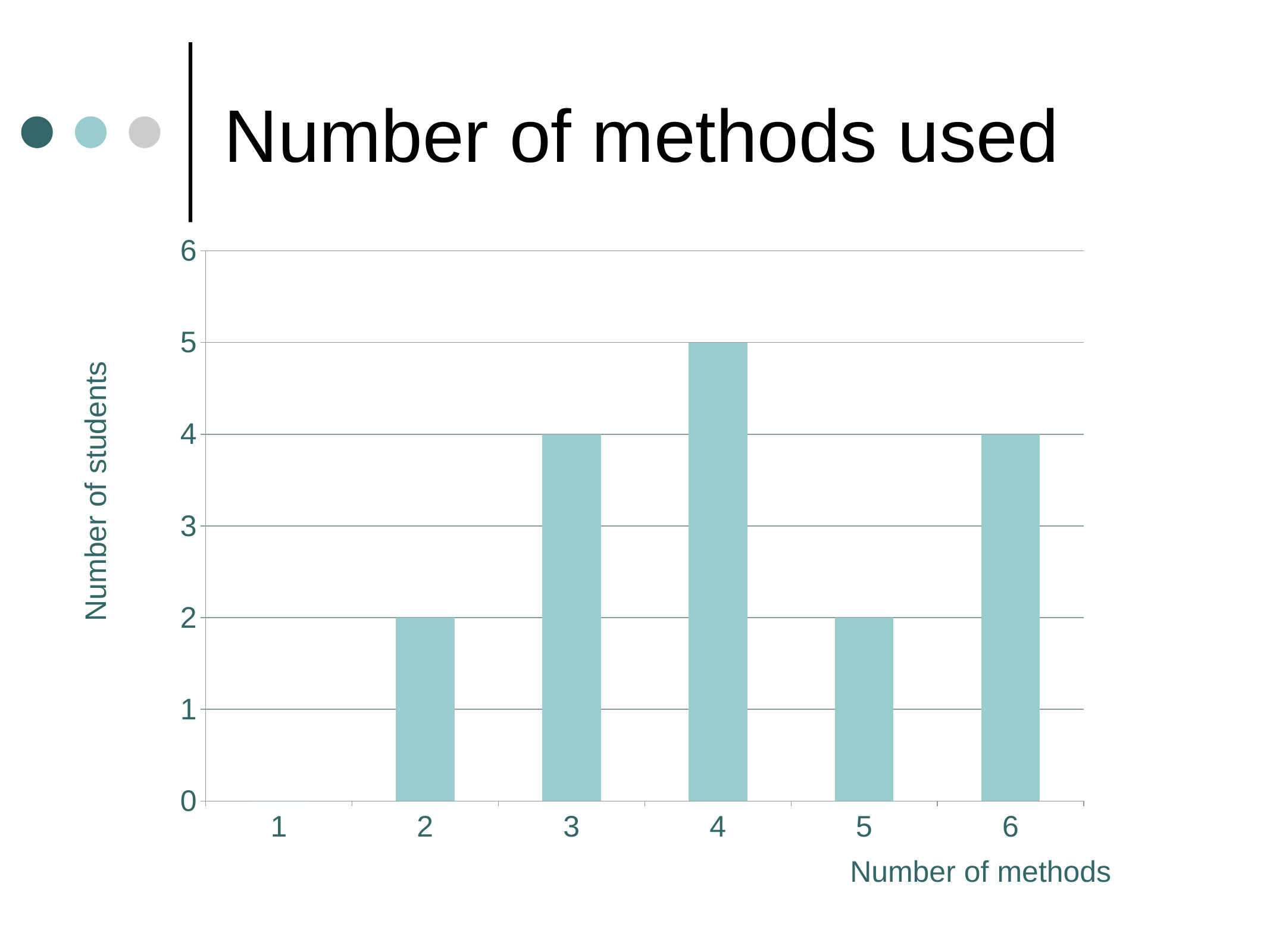
How many categories are shown on the x axis? 6 Which has more students: 3 methods or 5 methods? 3 methods Is the number of students who used 4 methods greater or less than 3? greater What type of chart is shown on the slide? bar chart What is the label of the y axis? Number of students How many students used 6 methods? 4 How many students used 4 methods? 5 Which number of methods has the highest number of students? 4 How many students used 2 methods? 2 How many students used 3 methods? 4 How many students used 5 methods? 2 What is the difference between the number of students who used 4 methods and the number who used 2 methods? 3